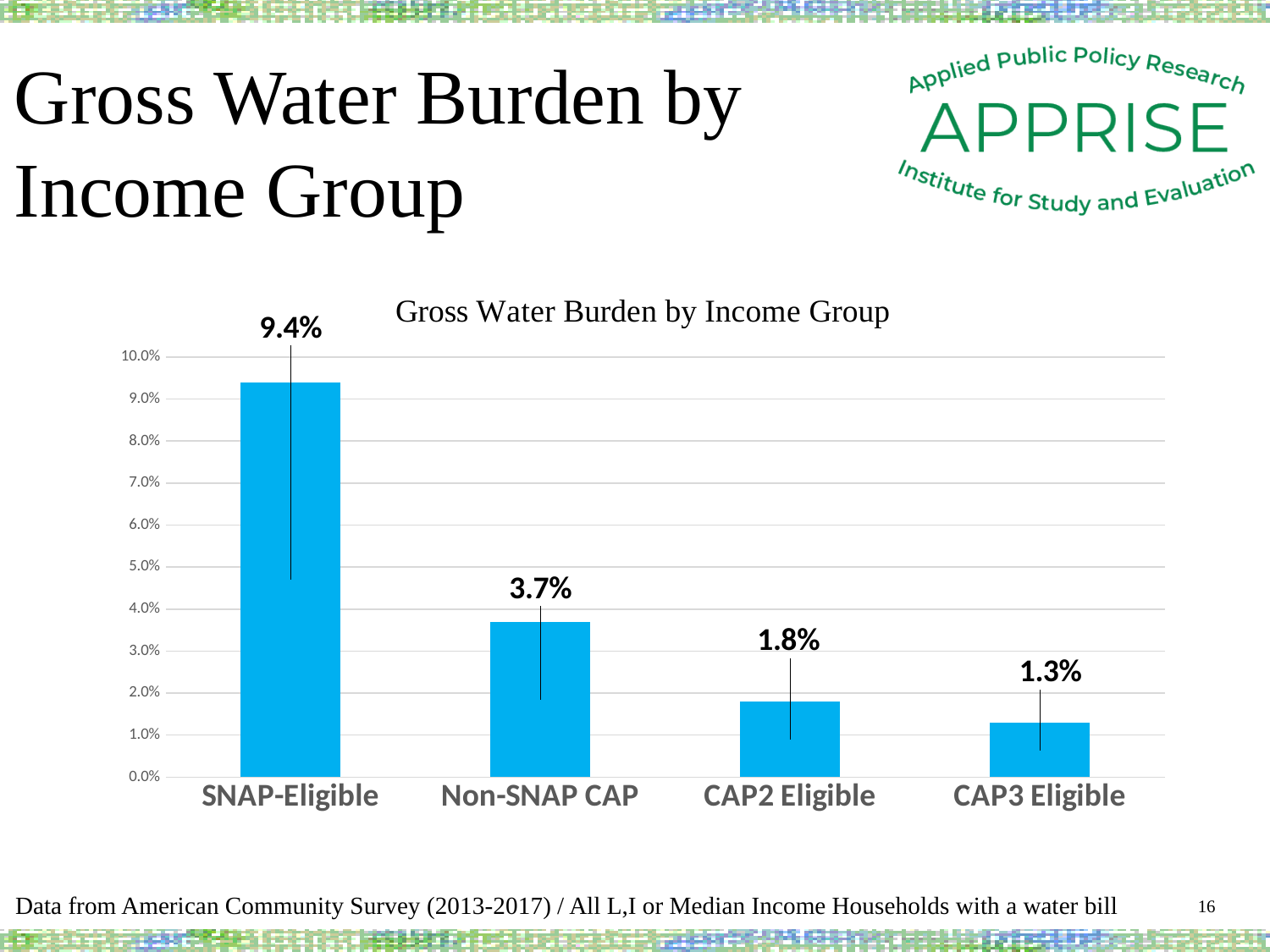
What is the gross water burden for CAP2 Eligible households? 1.8% What type of chart is shown on the slide? Bar chart How many income groups are shown in the chart? 4 Which income group has the highest gross water burden? SNAP-Eligible Do the values rise or fall moving from left to right across the income groups? Fall Which has a larger gross water burden, Non-SNAP CAP or CAP2 Eligible? Non-SNAP CAP What is the gross water burden for CAP3 Eligible households? 1.3% What is the difference in gross water burden between SNAP-Eligible and Non-SNAP CAP households? 5.7% What is the gross water burden for SNAP-Eligible households? 9.4% What is the difference in gross water burden between CAP2 Eligible and CAP3 Eligible households? 0.5% What is the gross water burden for Non-SNAP CAP households? 3.7% Which income group has the lowest gross water burden? CAP3 Eligible